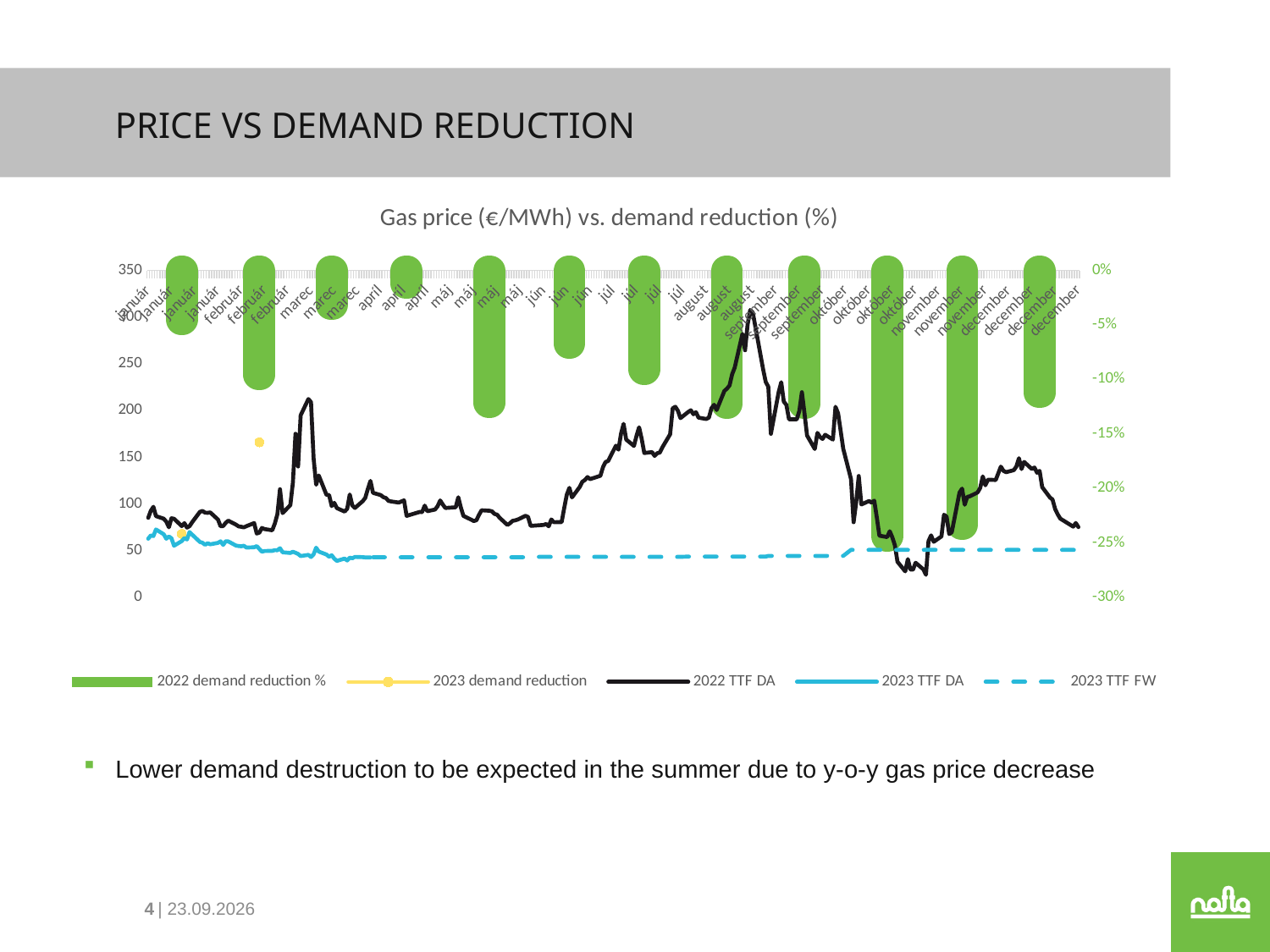
What kind of chart is shown on the slide? Combined bar and line chart Is the 2023 TTF FW dashed line greater or less than 100 on the left axis? less Does the 2023 TTF DA line rise or fall from január to marec? fall How many green 2022 demand reduction bars are plotted? 12 Which month has the larger 2022 demand reduction bar, október or december? október Which month has the larger 2022 demand reduction bar, január or február? február Is the 2022 demand reduction for október greater or less than -20%? less Is the 2022 TTF DA value at the start of január greater or less than 150? less Which series is drawn as green bars? 2022 demand reduction % What is the title of the chart? Gas price (€/MWh) vs. demand reduction (%) How many series does the chart legend list? 5